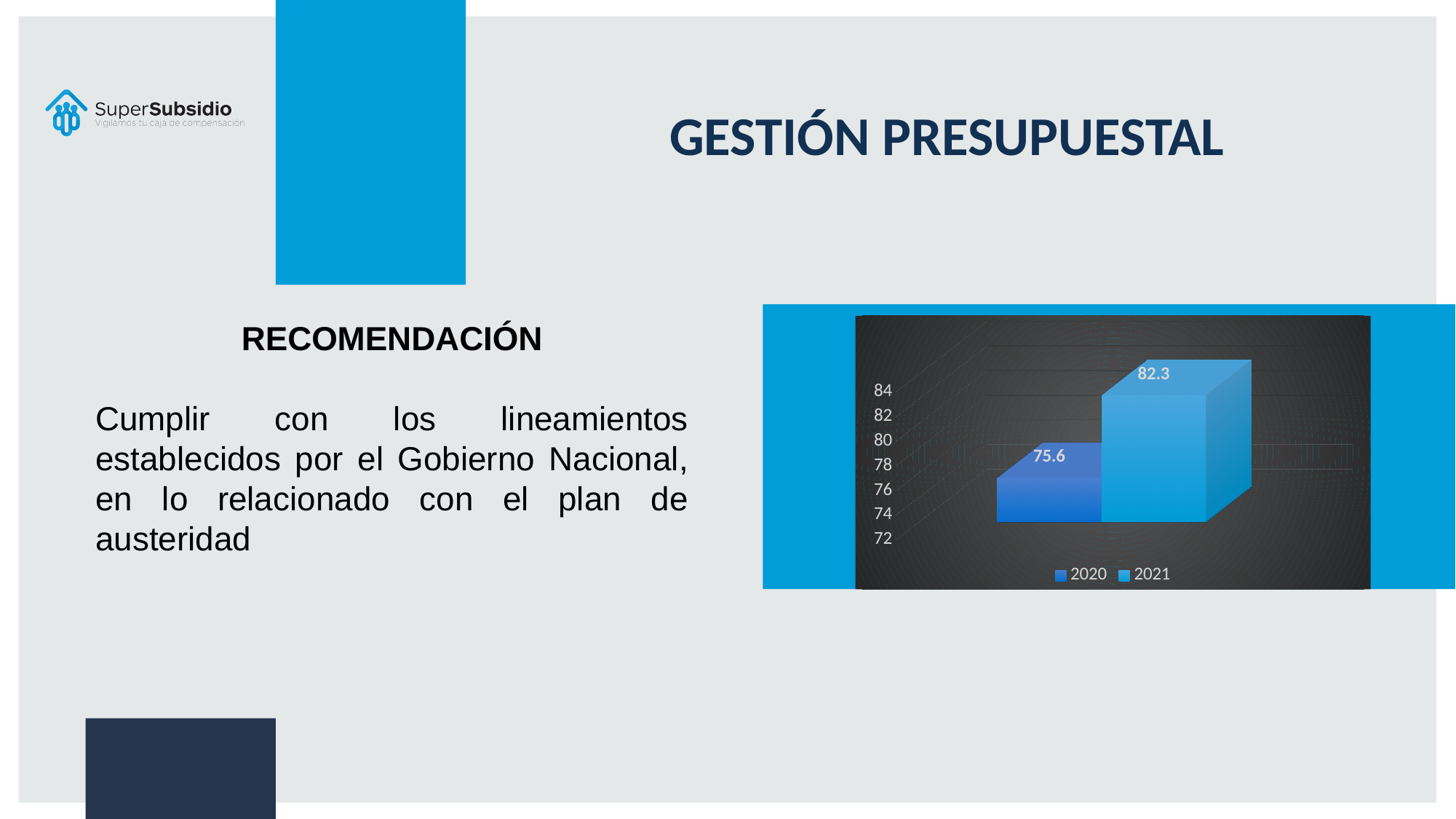
What kind of chart is shown on the slide? bar chart What is the value for 2020 in the chart? 75.6 What is the value for 2021 in the chart? 82.3 What is the difference between the 2021 and 2020 values in the chart? 6.7 Is the value for 2021 larger or smaller than the value for 2020? larger Is the value for 2021 greater or less than 80? greater Which year has the lower value in the chart? 2020 Which year has the higher value in the chart? 2021 Is the value for 2020 greater or less than 80? less Does the value rise or fall from 2020 to 2021? rise How many series does the chart legend list? 2 What are the legend entries of the chart? 2020, 2021